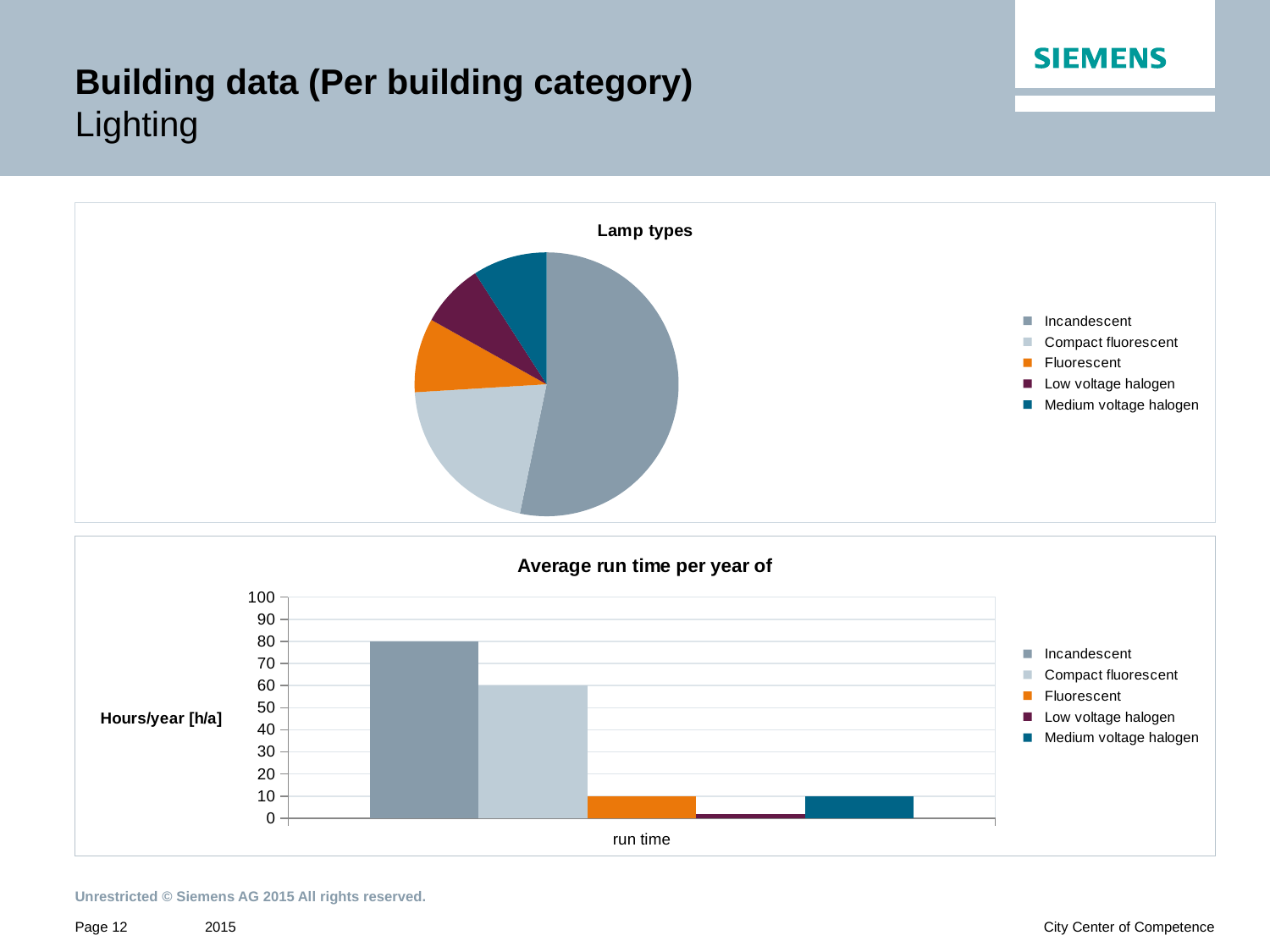
In the "Lamp types" pie chart, which slice is larger: Compact fluorescent or Fluorescent? Compact fluorescent In the "Average run time per year of" chart, what is the run time for Compact fluorescent? 60 What type of chart is the "Average run time per year of" chart? bar chart What type of chart is the "Lamp types" chart? pie chart In the "Lamp types" pie chart, which lamp type has the largest slice? Incandescent In the "Lamp types" pie chart, how many slices are there? 5 In the "Average run time per year of" chart, what is the run time for Fluorescent? 10 How many series does the legend of the "Average run time per year of" chart list? 5 In the "Average run time per year of" chart, which lamp type has the highest run time? Incandescent In the "Average run time per year of" chart, what is the run time for Incandescent? 80 In the "Average run time per year of" chart, what is the difference between the run time for Incandescent and Compact fluorescent? 20 In the "Average run time per year of" chart, is the value for Low voltage halogen greater or less than 10? less